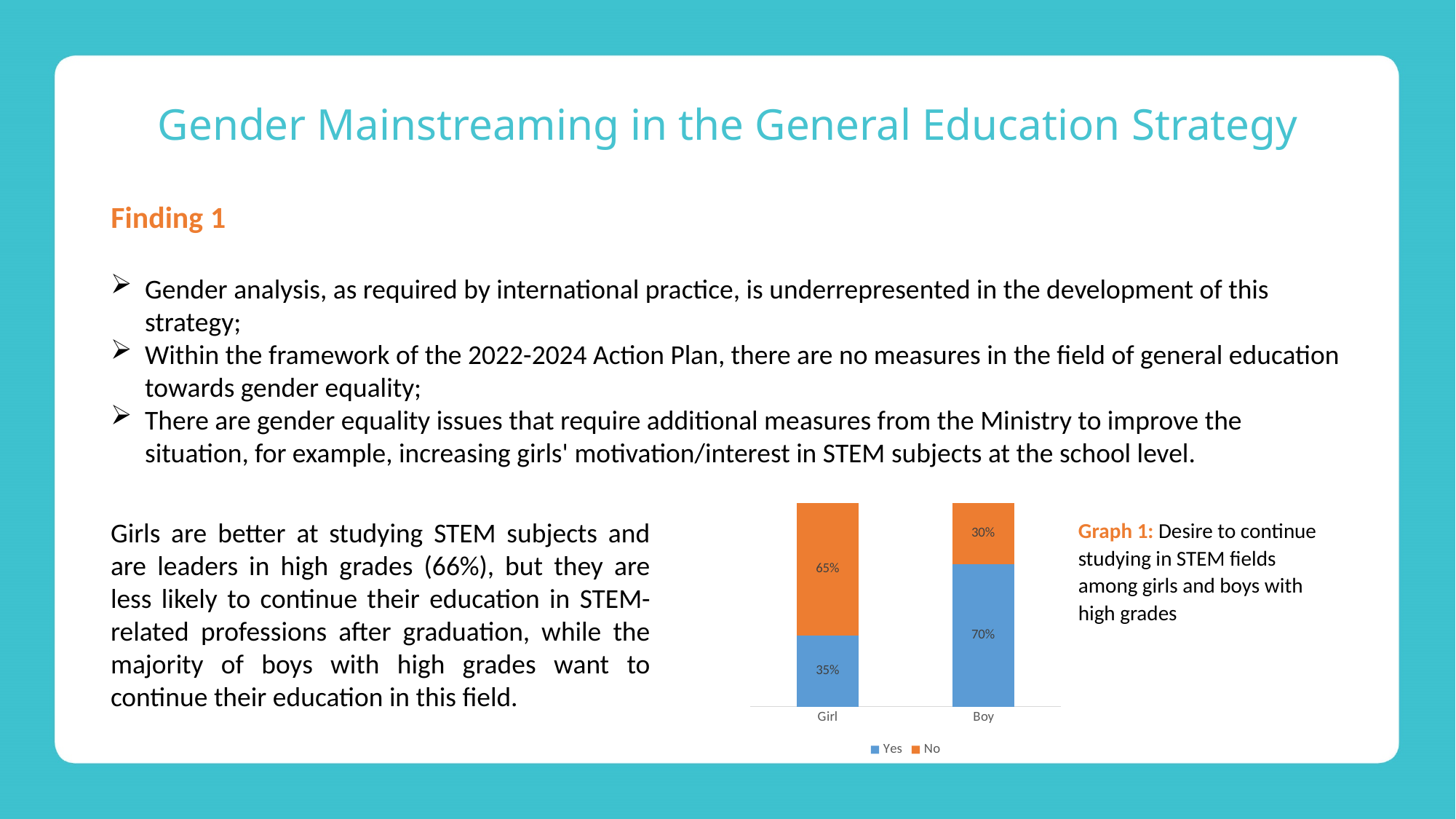
What is the difference between the 'No' values for Girl and Boy? 35% Which category has the higher 'Yes' value, Girl or Boy? Boy What is the 'No' value for Girl in the chart? 65% How many series does the chart legend list? 2 What is the total of the stacked bar for Girl? 100% What kind of chart is shown on the slide? Stacked bar chart Which category has the higher 'No' value, Girl or Boy? Girl What is the 'Yes' value for Girl in the chart? 35% What is the difference between the 'Yes' values for Boy and Girl? 35% What is the 'Yes' value for Boy in the chart? 70% How many categories are shown on the x axis of the chart? 2 What is the 'No' value for Boy in the chart? 30%